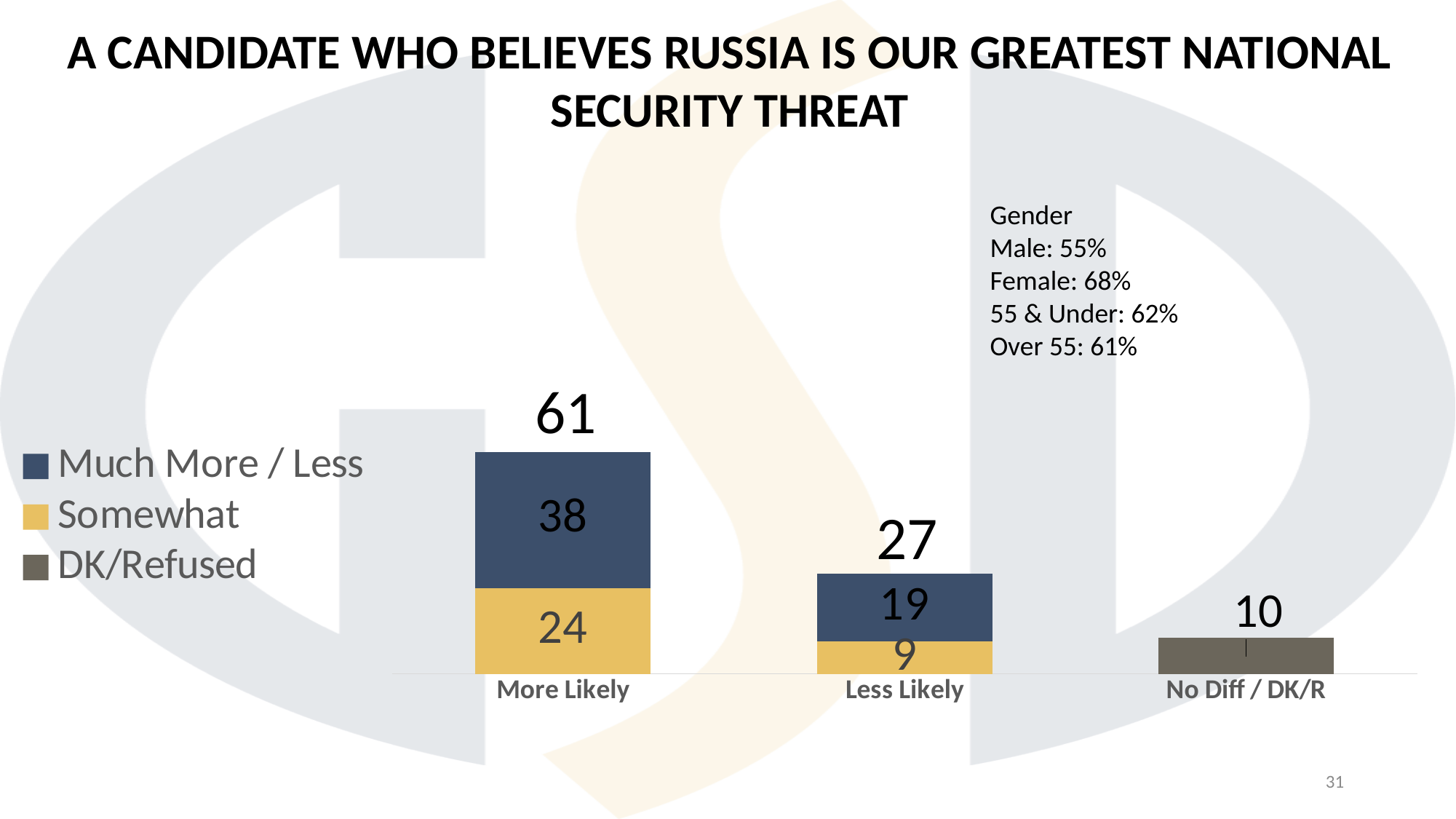
What is the total shown above the Less Likely bar? 27 Which is larger: the 'Somewhat' value for More Likely or the 'Much More / Less' value for Less Likely? Somewhat value for More Likely Which category has the lowest total? No Diff / DK/R Which category has the highest total? More Likely How many categories are shown on the x axis? 3 How many series does the legend list? 3 What kind of chart is shown on the slide? Stacked bar chart What is the difference between the More Likely total and the Less Likely total? 34 What is the value for No Diff / DK/R? 10 What is the 'Somewhat' value for the Less Likely bar? 9 What is the total shown above the More Likely bar? 61 What is the 'Much More / Less' value for the More Likely bar? 38